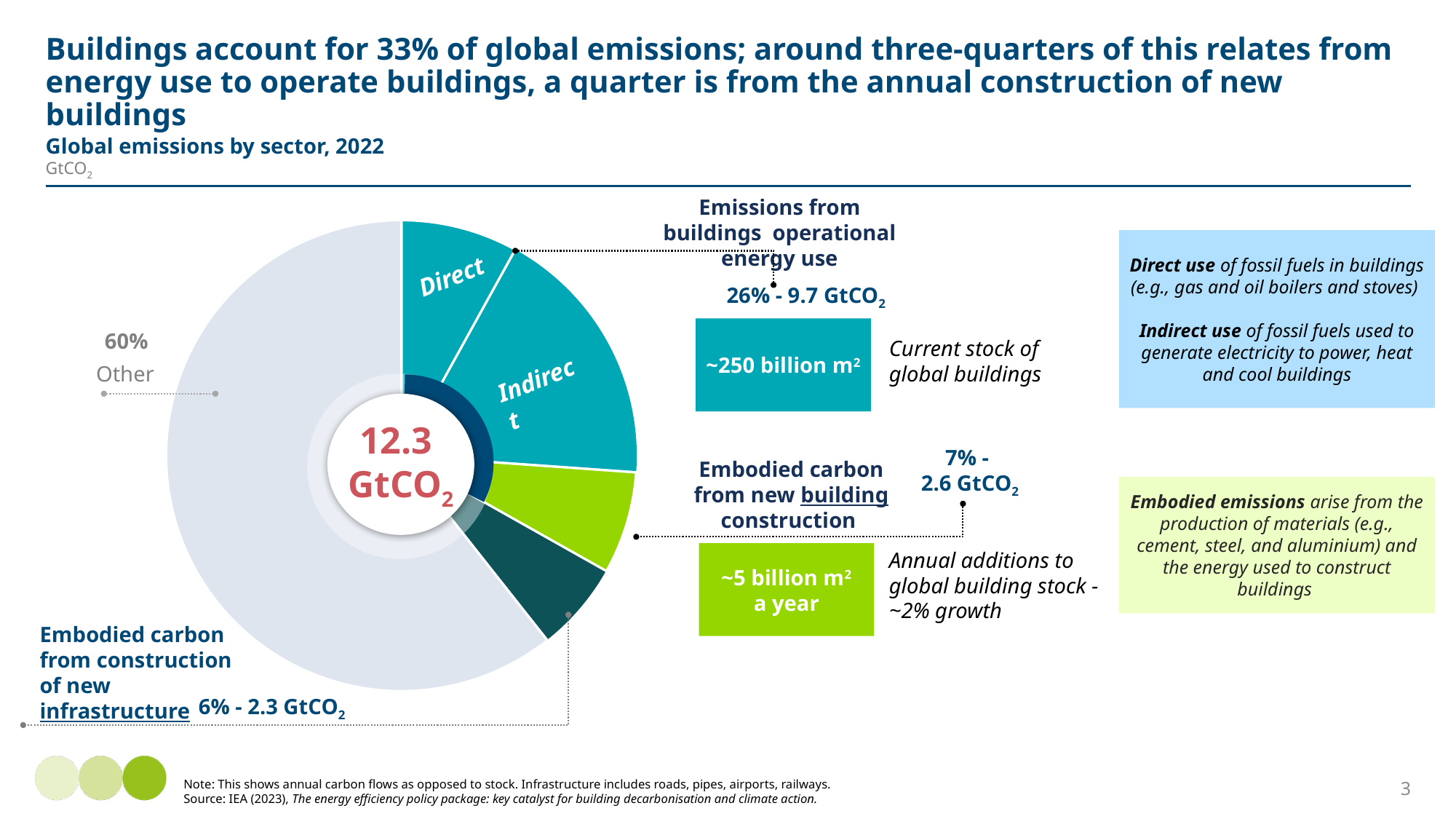
Which slice of the chart is the largest? Other What type of chart is shown on the slide? Pie (donut) chart What share of global emissions is embodied carbon from new building construction? 7% Which is larger: embodied carbon from new building construction or embodied carbon from construction of new infrastructure? Embodied carbon from new building construction How many GtCO2 are attributed to emissions from buildings' operational energy use? 9.7 GtCO2 What share of global emissions comes from buildings' operational energy use? 26% What is the title of the chart? Global emissions by sector, 2022 Which of the labelled building-related slices is the smallest? Embodied carbon from construction of new infrastructure What is the difference in GtCO2 between buildings' operational energy use emissions and embodied carbon from new building construction? 7.1 GtCO2 What value is shown in the centre of the donut chart? 12.3 GtCO2 How many GtCO2 are attributed to embodied carbon from construction of new infrastructure? 2.3 GtCO2 What share of global emissions does the "Other" slice represent? 60%